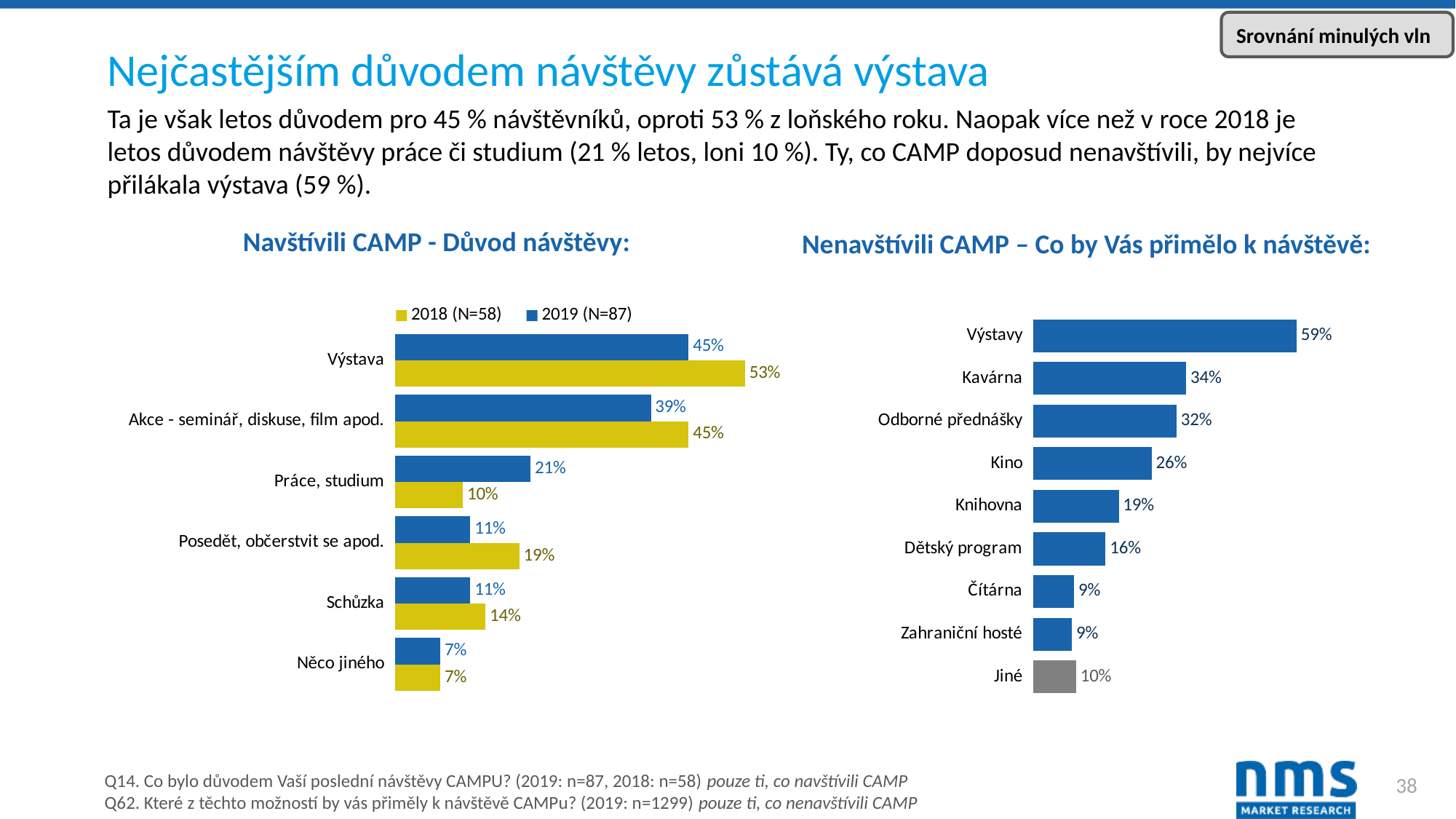
In the 'Navštívili CAMP - Důvod návštěvy' chart, how many series does the legend list? 2 In the 'Navštívili CAMP - Důvod návštěvy' chart, which is larger for Akce - seminář, diskuse, film apod.: the 2018 value or the 2019 value? 2018 In the 'Navštívili CAMP - Důvod návštěvy' chart, what is the difference between the 2018 and 2019 values for Posedět, občerstvit se apod.? 8% In the 'Navštívili CAMP - Důvod návštěvy' chart, what is the 2019 value for Výstava? 45% What type of chart is the 'Nenavštívili CAMP – Co by Vás přimělo k návštěvě' chart? Bar chart In the 'Nenavštívili CAMP – Co by Vás přimělo k návštěvě' chart, how many categories are shown? 9 In the 'Navštívili CAMP - Důvod návštěvy' chart, how many categories are shown? 6 In the 'Nenavštívili CAMP – Co by Vás přimělo k návštěvě' chart, what is the difference between Výstavy and Kino? 33% In the 'Navštívili CAMP - Důvod návštěvy' chart, what is the 2018 value for Práce, studium? 10% In the 'Nenavštívili CAMP – Co by Vás přimělo k návštěvě' chart, what is the value for Kavárna? 34% In the 'Nenavštívili CAMP – Co by Vás přimělo k návštěvě' chart, which category's bar is coloured grey instead of blue? Jiné In the 'Nenavštívili CAMP – Co by Vás přimělo k návštěvě' chart, which category has the highest value? Výstavy